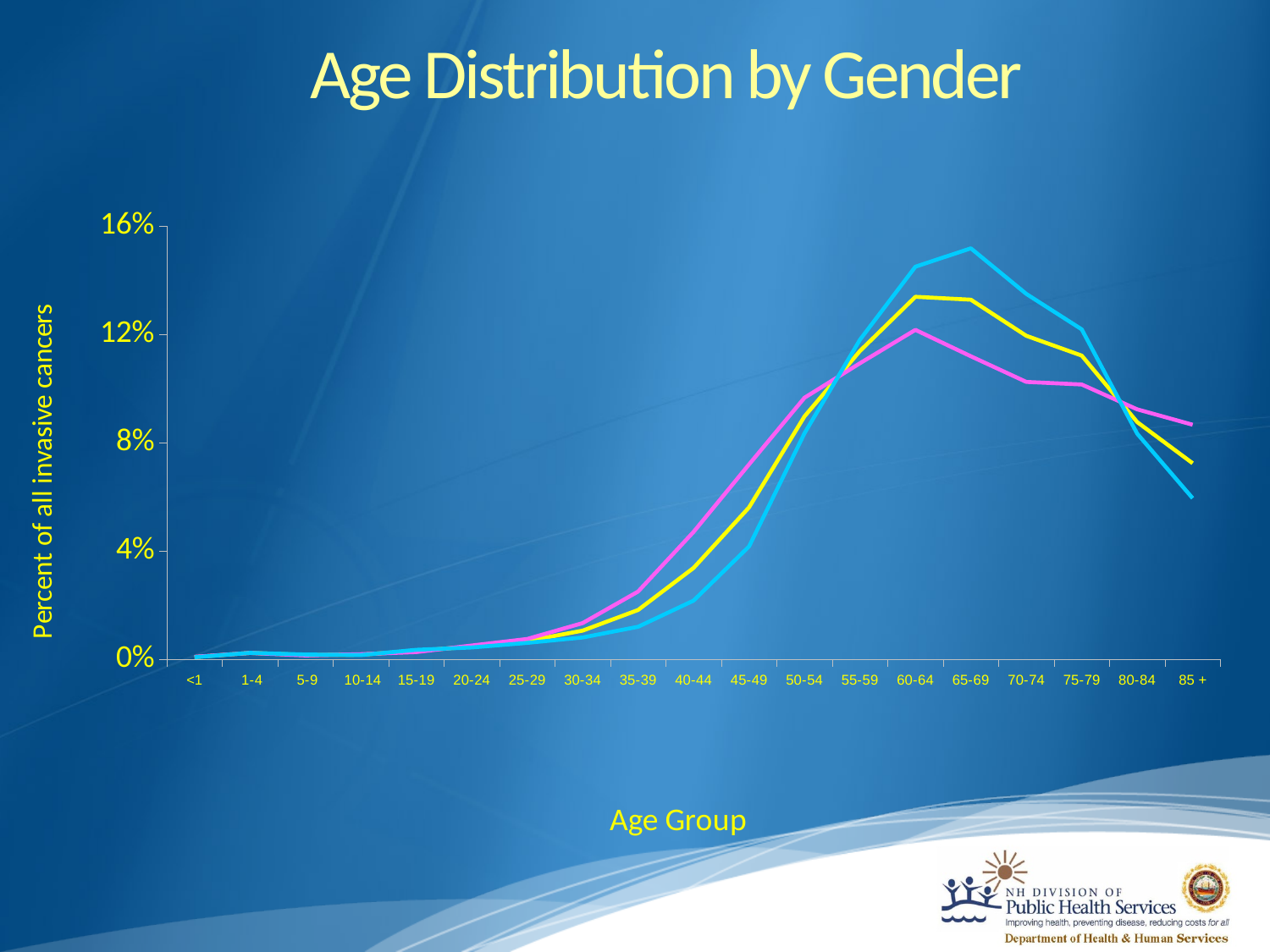
Is the value of the yellow line at 40-44 greater or less than 4%? less Is the value of the cyan line at 65-69 greater or less than 12%? greater What is the label on the vertical axis of the chart? Percent of all invasive cancers Is the value of the cyan line at 85 + greater or less than 8%? less How many age group categories are shown on the x axis? 19 At which age group does the magenta line reach its highest value? 60-64 At which age group does the cyan line reach its highest value? 65-69 At the 85 + age group, which line has the higher value, the magenta line or the cyan line? magenta line Does the cyan line rise or fall from 65-69 to 85 +? fall What kind of chart is shown on the slide? line chart What is the title of the chart? Age Distribution by Gender How many lines are plotted on the chart? 3